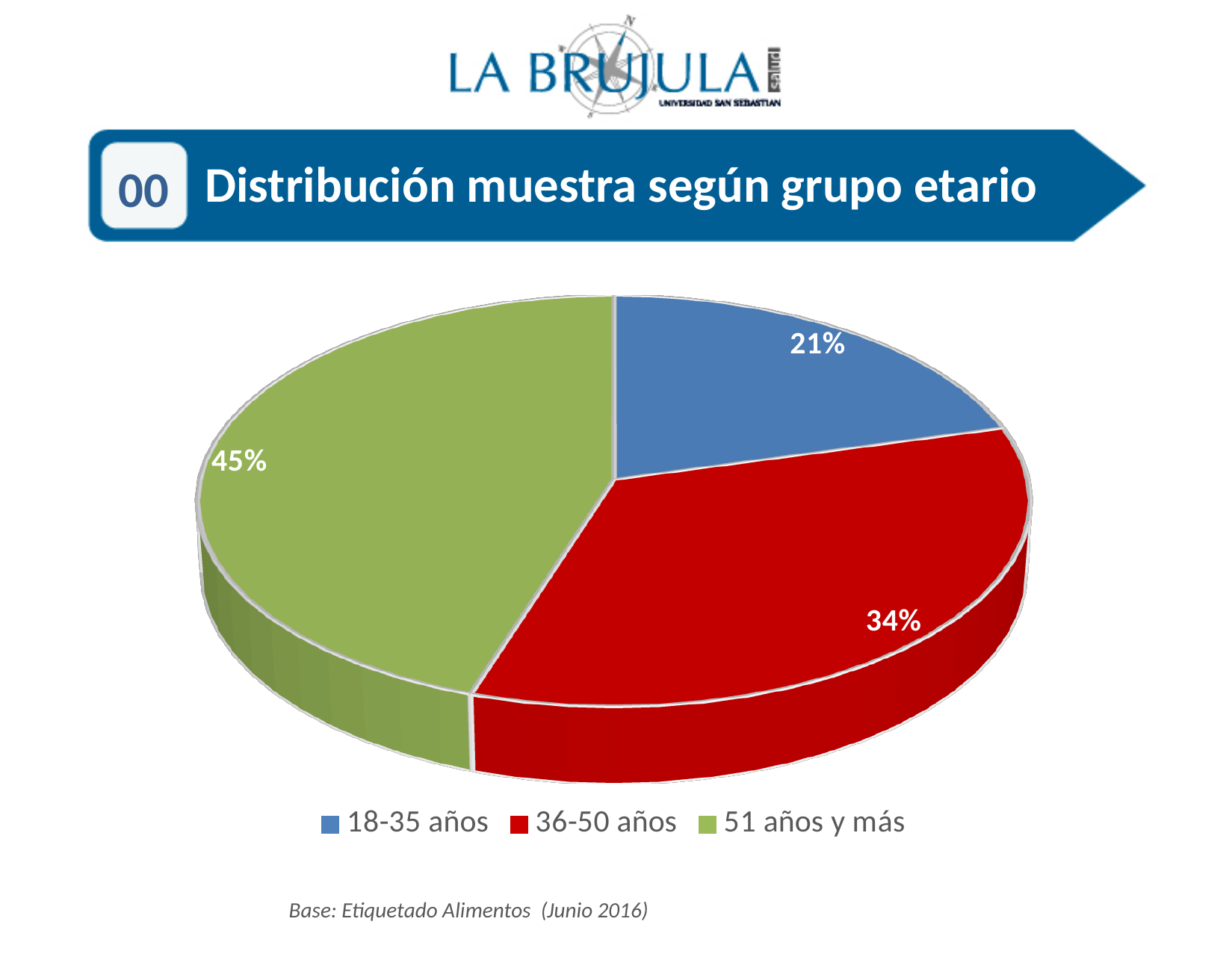
What percentage of the sample is in the 18-35 años group? 21% What is the difference in percentage points between the 36-50 años group and the 18-35 años group? 13 What percentage of the sample is in the 51 años y más group? 45% What is the difference in percentage points between the 51 años y más group and the 18-35 años group? 24 What is the title of the chart on the slide? Distribución muestra según grupo etario What kind of chart is shown on the slide? Pie chart How many age groups are shown in the pie chart? 3 Which colour represents the 36-50 años group in the pie chart? Red Which age group has the largest share of the sample? 51 años y más What percentage of the sample is in the 36-50 años group? 34% Which age group has the smallest share of the sample? 18-35 años Which group has a larger share: 36-50 años or 18-35 años? 36-50 años